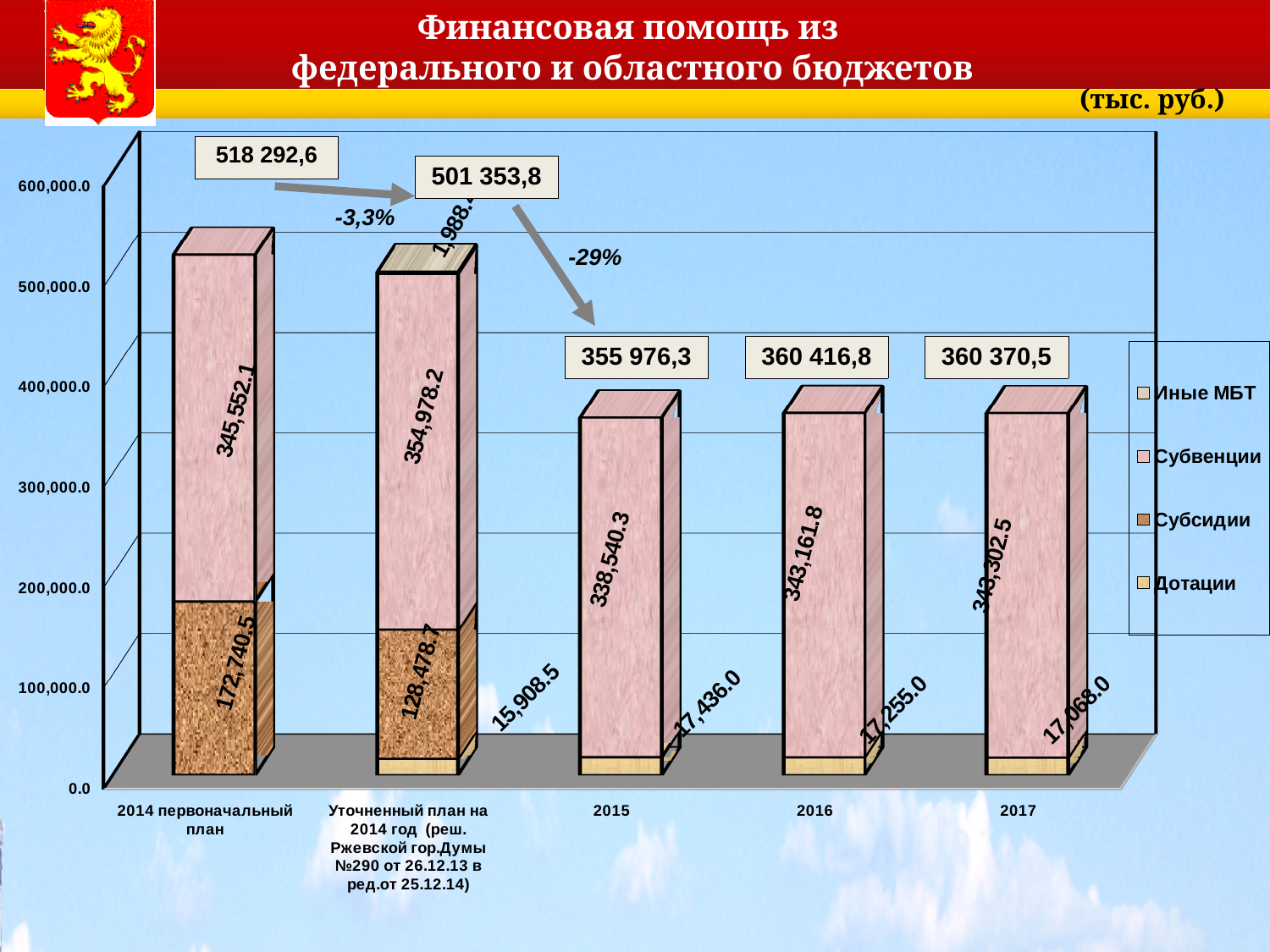
What percentage change is shown between the Уточненный план на 2014 год and 2015? -29% Which category has the highest total financial aid? 2014 первоначальный план What is the total financial aid shown for 2015? 355 976,3 What kind of chart is shown on the slide? Stacked bar chart What is the value of Дотации for 2017? 17,068.0 What is the value of Субвенции for 2016? 343,161.8 What is the difference between the Субсидии values for the 2014 первоначальный план and the Уточненный план на 2014 год? 44,261.8 How many categories are shown on the x axis? 5 Which category has the lowest total financial aid? 2015 How many series does the legend list? 4 Which is larger, the Субвенции value for 2015 or for 2017? 2017 What is the value of Субсидии for the 2014 первоначальный план? 172,740.5